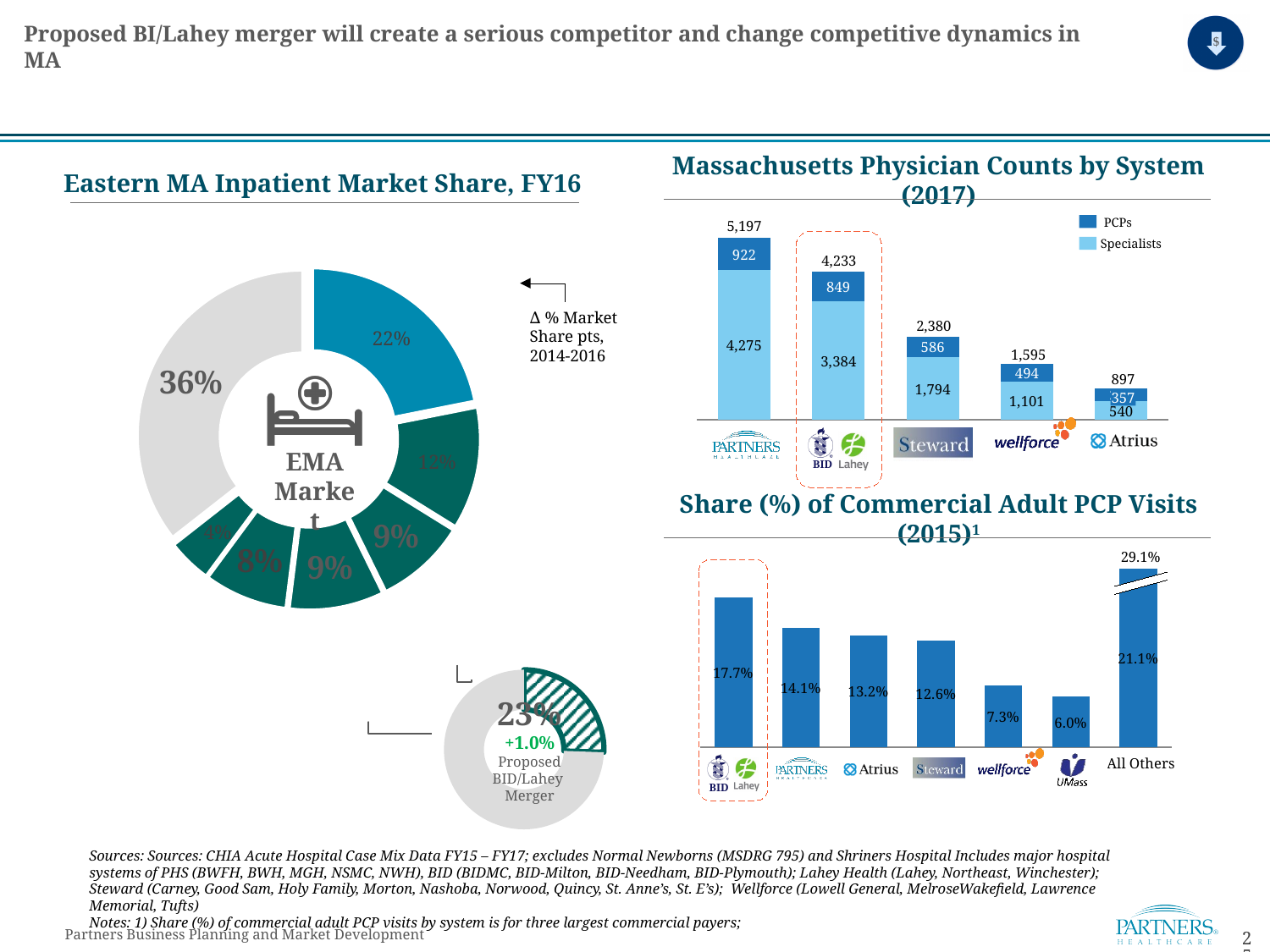
In the Massachusetts Physician Counts by System (2017) chart, which system has the lowest total physician count? Atrius In the Massachusetts Physician Counts by System (2017) chart, how many systems are shown? 5 In the Massachusetts Physician Counts by System (2017) chart, what is the difference between the total physician counts of Partners and BID/Lahey? 964 In the Massachusetts Physician Counts by System (2017) chart, what is the total physician count for Partners? 5,197 In the Massachusetts Physician Counts by System (2017) chart, how many series does the legend list? 2 In the Massachusetts Physician Counts by System (2017) chart, how many Specialists does Steward have? 1,794 In the Share (%) of Commercial Adult PCP Visits (2015) chart, what is the difference between the shares of Partners and UMass? 8.1% In the Massachusetts Physician Counts by System (2017) chart, how many PCPs does BID/Lahey have? 849 What kind of chart is the Eastern MA Inpatient Market Share, FY16 chart? Donut (pie) chart In the Share (%) of Commercial Adult PCP Visits (2015) chart, what is the share for Wellforce? 7.3% In the Share (%) of Commercial Adult PCP Visits (2015) chart, which has the larger share, Atrius or Steward? Atrius In the Share (%) of Commercial Adult PCP Visits (2015) chart, what is the share for BID/Lahey? 17.7%